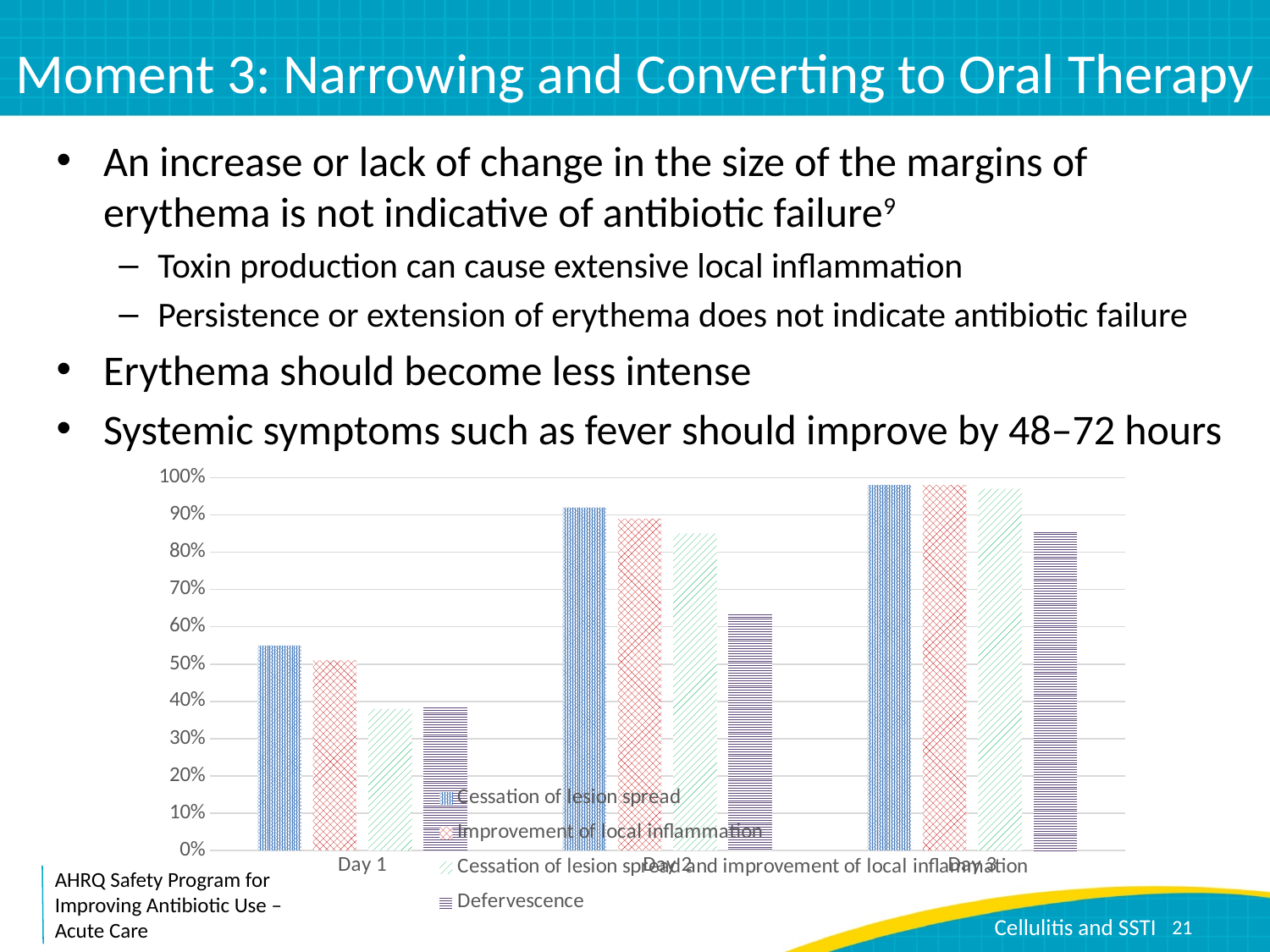
Is the value for Defervescence on Day 2 greater or less than 70%? less Does the value for Defervescence rise or fall from Day 1 to Day 3? Rise On Day 2, which series has the lowest value? Defervescence What kind of chart is shown on the slide? Bar chart How many day categories are shown on the x axis of the chart? 3 Is the value for Cessation of lesion spread on Day 2 greater or less than 80%? greater How many series does the chart's legend list? 4 Is the value for Defervescence on Day 3 greater or less than 70%? greater On Day 2, which is larger: Cessation of lesion spread or Defervescence? Cessation of lesion spread Which series is listed last in the chart's legend? Defervescence